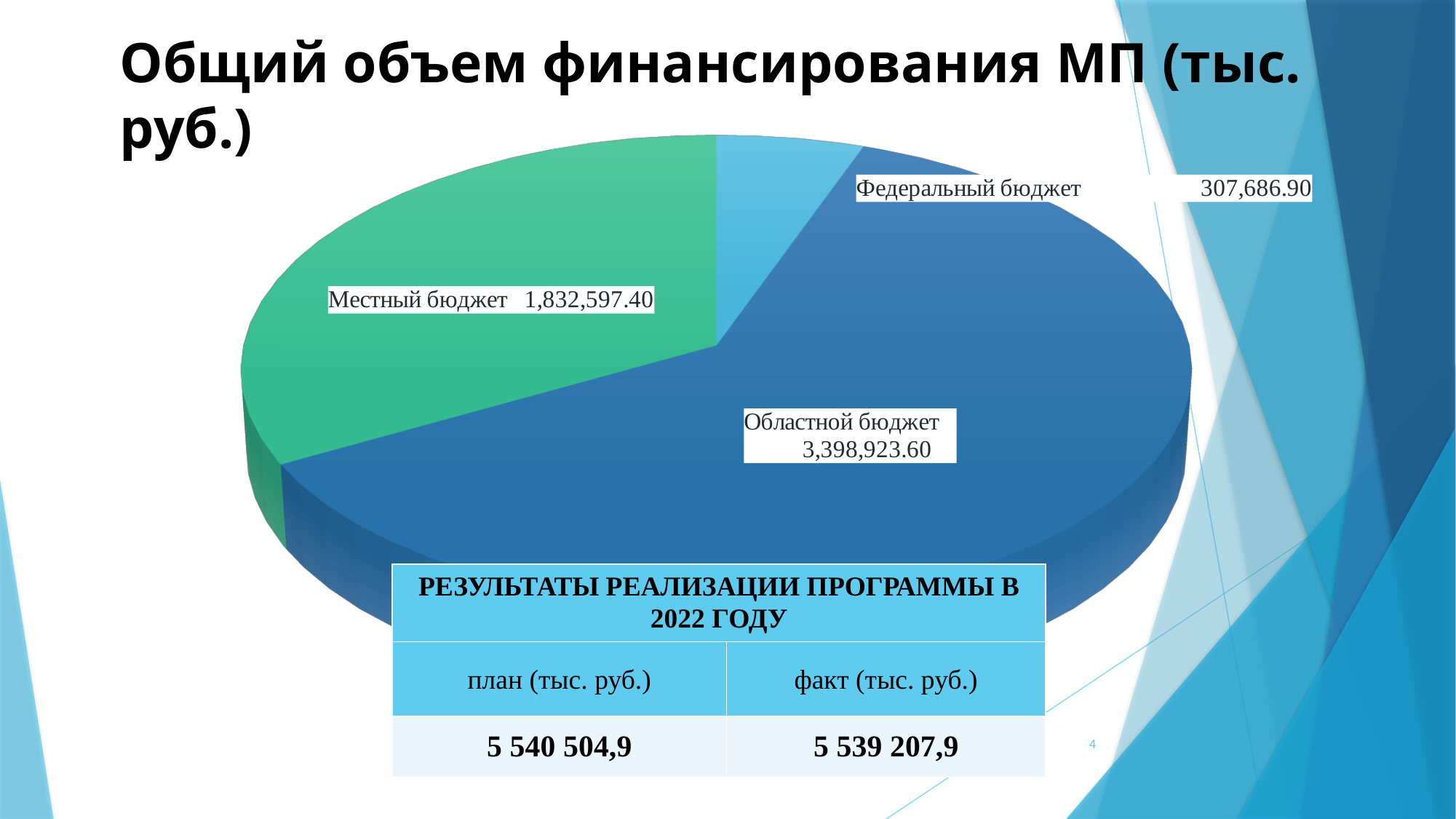
What is the value for Местный бюджет in the pie chart? 1,832,597.40 What is the difference between the values for Местный бюджет and Федеральный бюджет? 1,524,910.50 What is the total of all three slices in the pie chart? 5,539,207.90 What type of chart is shown on the slide? Pie chart What is the title of the chart on the slide? Общий объем финансирования МП (тыс. руб.) How many slices does the pie chart have? 3 Which budget source has the smallest slice in the pie chart? Федеральный бюджет Which budget source has the largest slice in the pie chart? Областной бюджет What is the value for Областной бюджет in the pie chart? 3,398,923.60 Which is larger: the value for Местный бюджет or the value for Федеральный бюджет? Местный бюджет What is the difference between the values for Областной бюджет and Местный бюджет? 1,566,326.20 What is the value for Федеральный бюджет in the pie chart? 307,686.90